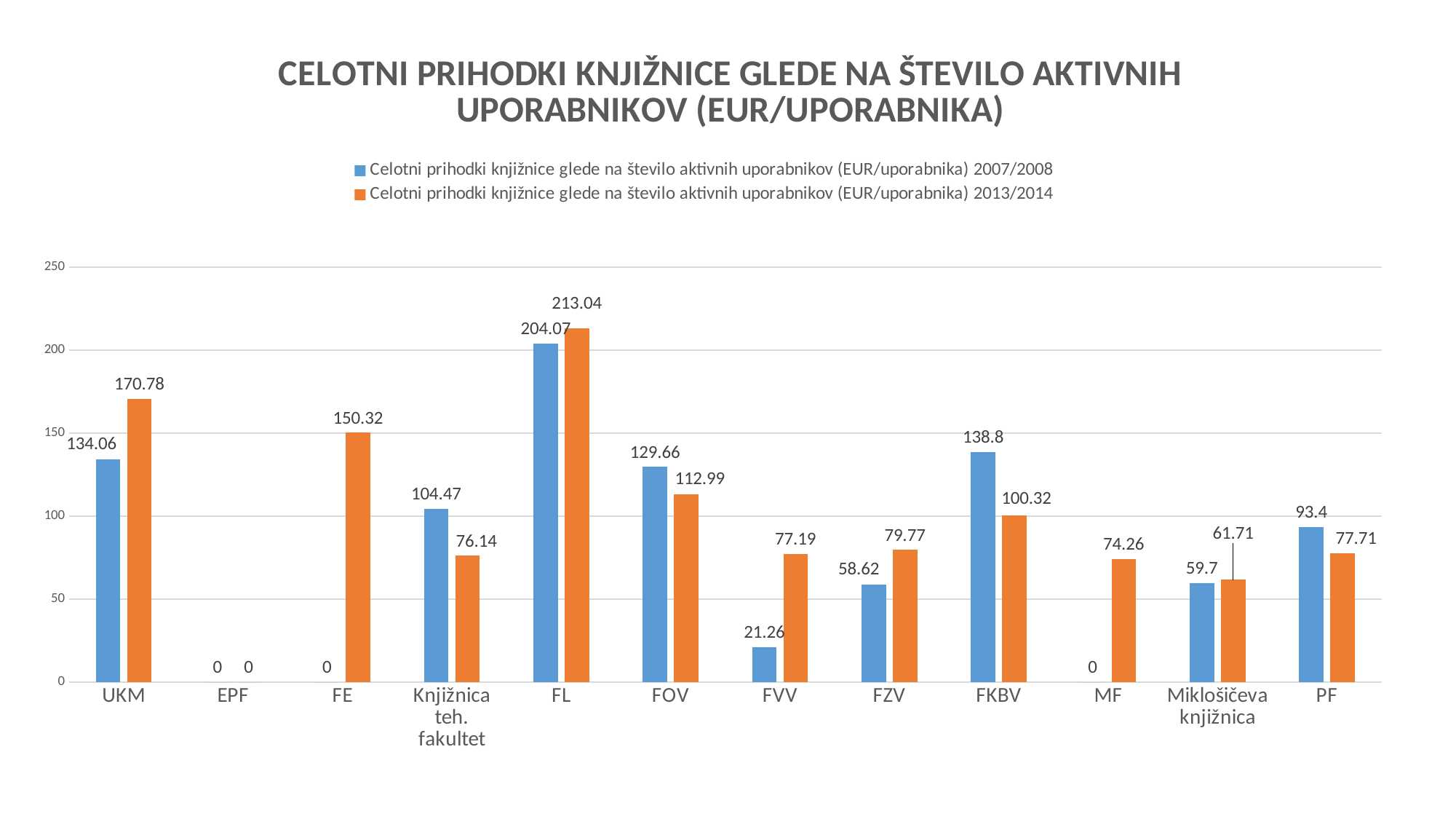
Is the 2013/2014 value for FE greater or less than 150? greater What is the difference between the 2007/2008 and 2013/2014 values for FKBV? 38.48 Which category has the lowest non-zero value in the 2007/2008 series? FVV Which category has the highest value in the 2007/2008 series? FL What is the difference between the 2013/2014 and 2007/2008 values for UKM? 36.72 How many categories are shown on the x axis? 12 What is the value for FL in the 2013/2014 series? 213.04 What kind of chart is shown on the slide? Bar chart Which is larger for FOV: the 2007/2008 value or the 2013/2014 value? 2007/2008 What is the value for MF in the 2013/2014 series? 74.26 How many series does the legend list? 2 What is the value for UKM in the 2007/2008 series? 134.06